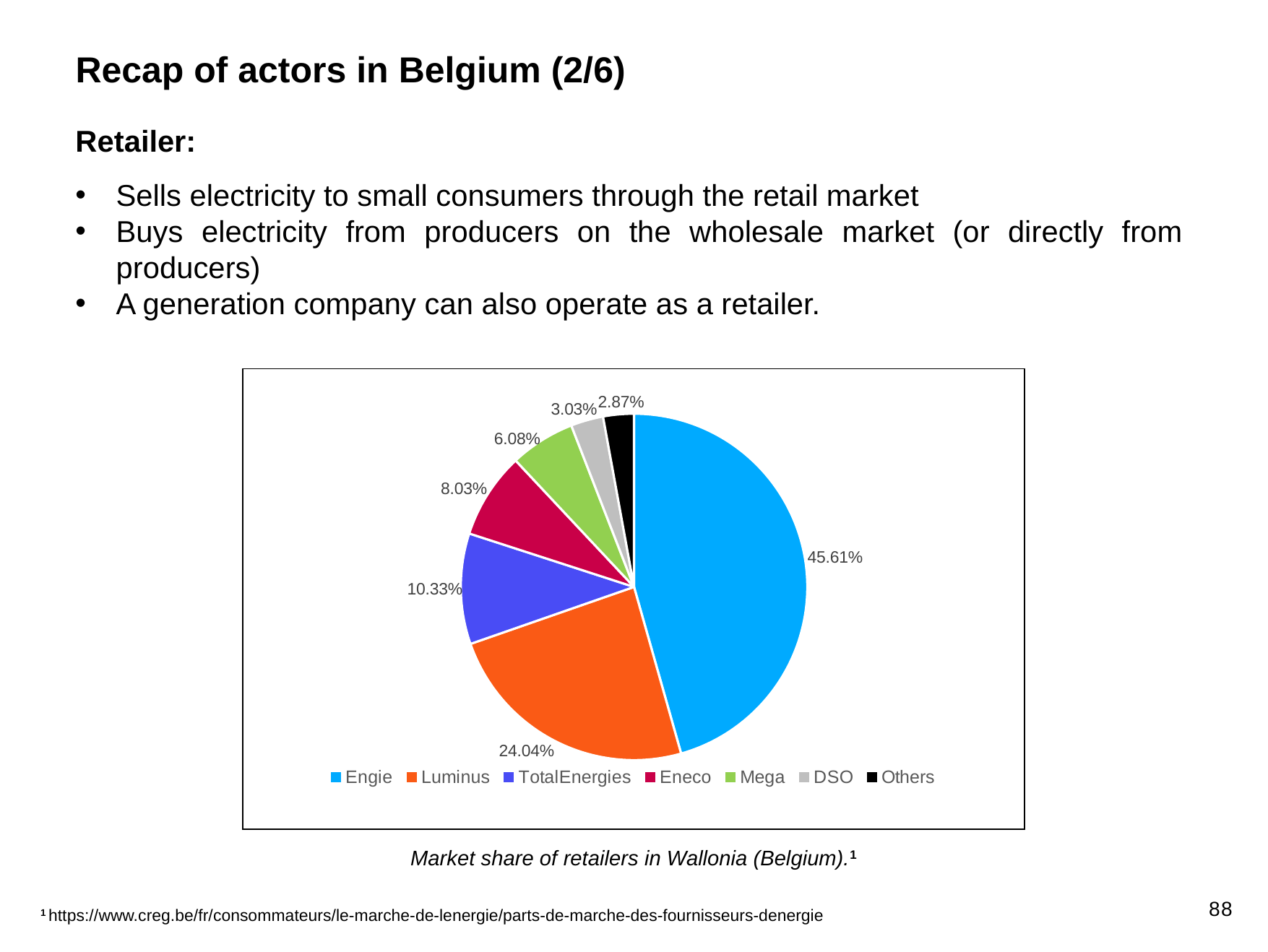
What is the market share of Engie? 45.61% How many retailers are shown in the pie chart? 7 What colour is the slice for Luminus? orange What kind of chart is shown on the slide? pie chart Which has a larger market share, TotalEnergies or Eneco? TotalEnergies What is the market share of Luminus? 24.04% What is the market share of Mega? 6.08% What is the market share of TotalEnergies? 10.33% Which retailer has the largest market share? Engie What is the difference between the market shares of Engie and Luminus? 21.57% Which retailer has the smallest market share? Others What is the market share of Eneco? 8.03%